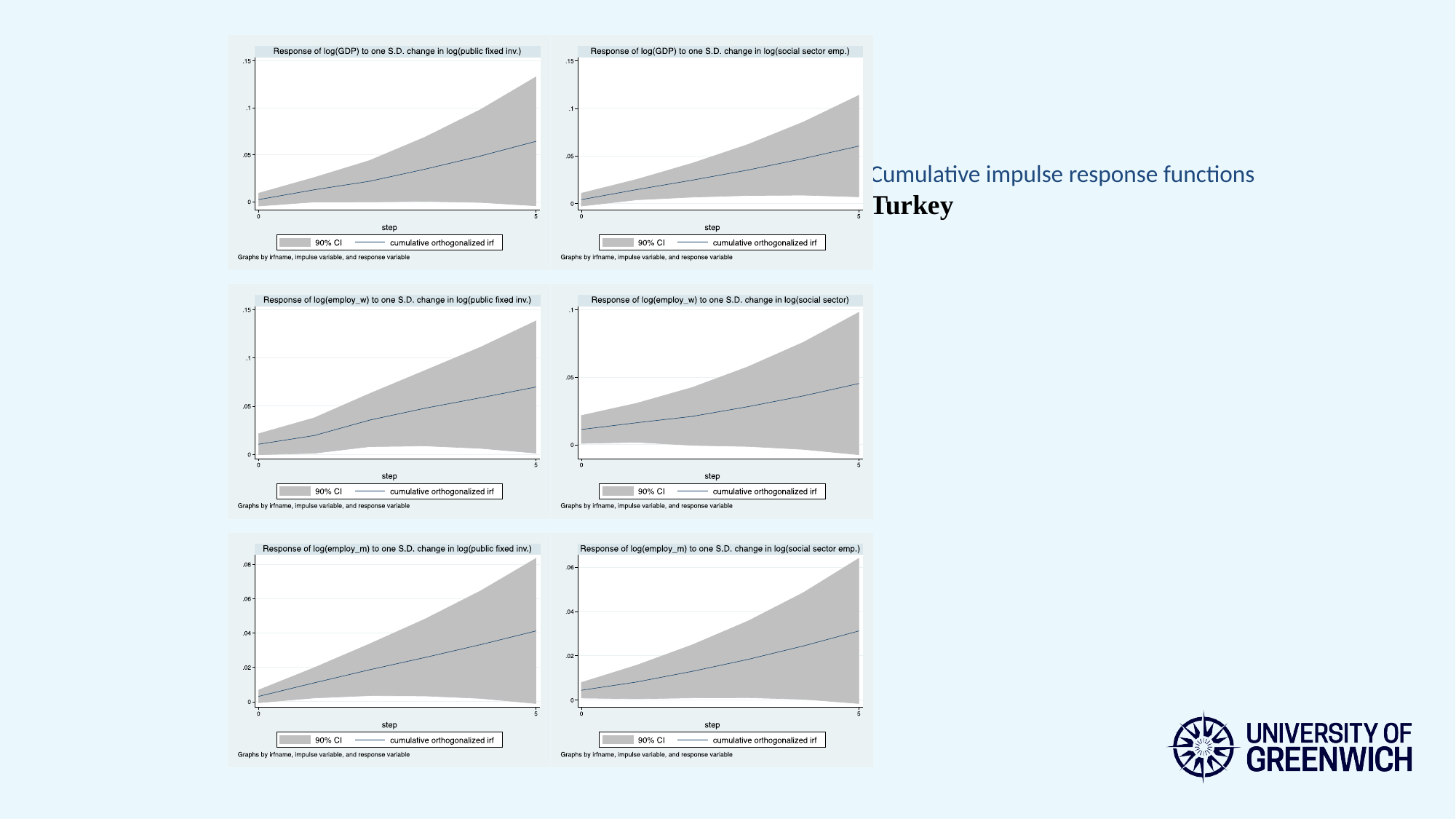
In the bottom-left chart (Response of log(employ_m) to one S.D. change in log(public fixed inv.)), is the value of the cumulative orthogonalized irf at step 5 greater or less than .06? less In the bottom-right chart (Response of log(employ_m) to one S.D. change in log(social sector emp.)), is the value of the cumulative orthogonalized irf at step 5 greater or less than .04? less What is the label of the x axis in the bottom-left chart (Response of log(employ_m) to one S.D. change in log(public fixed inv.))? step In the bottom-right chart (Response of log(employ_m) to one S.D. change in log(social sector emp.)), does the cumulative orthogonalized irf line rise or fall along the step axis? rise In the top-left chart (Response of log(GDP) to one S.D. change in log(public fixed inv.)), is the value of the cumulative orthogonalized irf at step 5 greater or less than .05? greater In the top-left chart (Response of log(GDP) to one S.D. change in log(public fixed inv.)), does the cumulative orthogonalized irf line rise or fall as step increases? rise In the top-left chart (Response of log(GDP) to one S.D. change in log(public fixed inv.)), what kind of chart is it? line chart How many charts are shown on the slide? 6 How many entries does the legend of the top-left chart (Response of log(GDP) to one S.D. change in log(public fixed inv.)) list? 2 In the middle-right chart (Response of log(employ_w) to one S.D. change in log(social sector)), what does the grey shaded area represent according to the legend? 90% CI